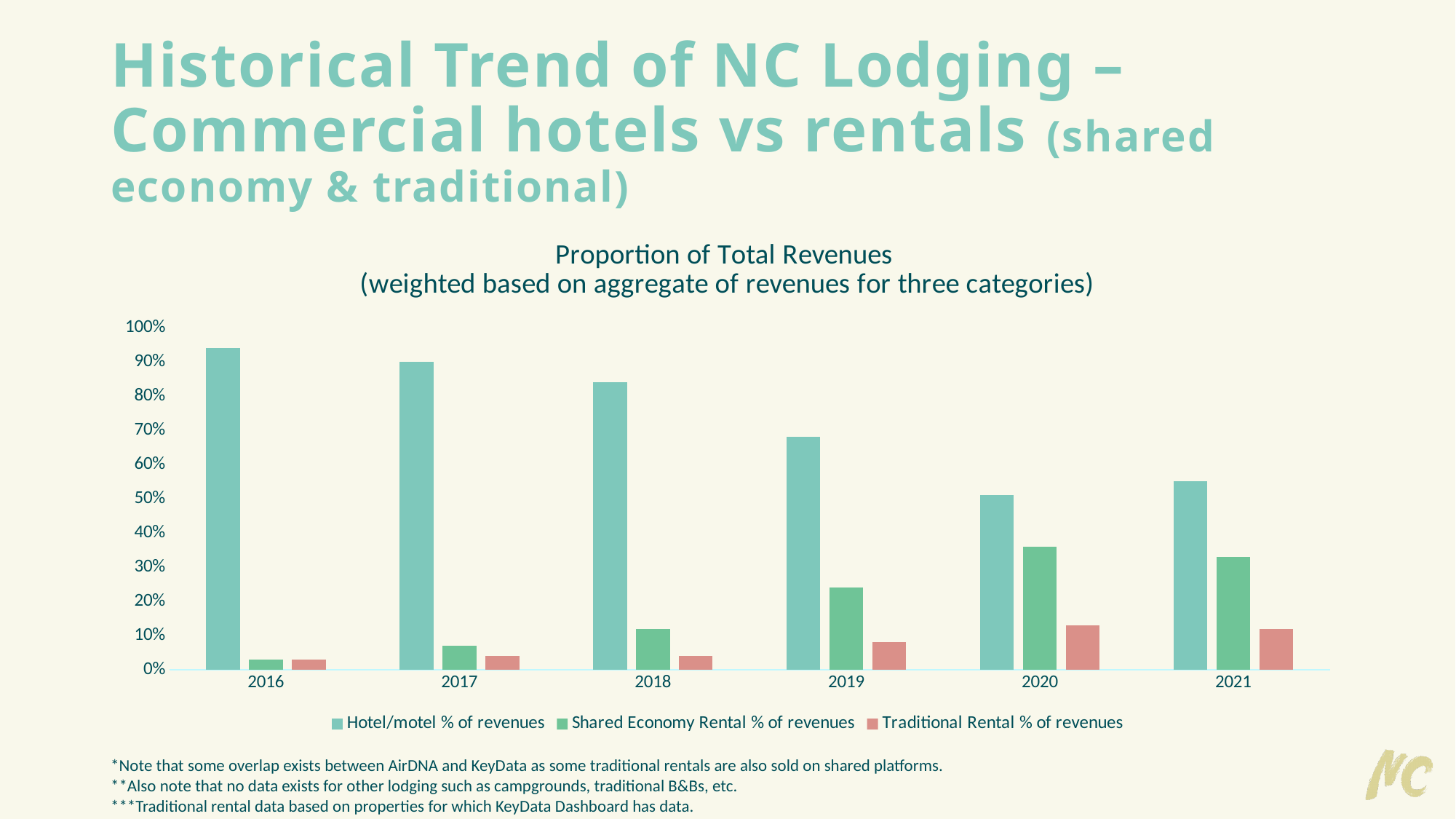
Which year has the highest Hotel/motel % of revenues? 2016 How many series does the legend list? 3 Is the Hotel/motel % of revenues for 2020 greater or less than 60%? less How many years are shown on the x axis? 6 Is the Hotel/motel % of revenues for 2016 greater or less than 90%? greater In 2021, which is larger: Shared Economy Rental % of revenues or Traditional Rental % of revenues? Shared Economy Rental % of revenues Is the Shared Economy Rental % of revenues for 2018 greater or less than 20%? less What kind of chart is shown on the slide? Bar chart Does the Hotel/motel % of revenues rise or fall from 2016 to 2020? Fall Which year has the highest Shared Economy Rental % of revenues? 2020 Which year has the lowest Hotel/motel % of revenues? 2020